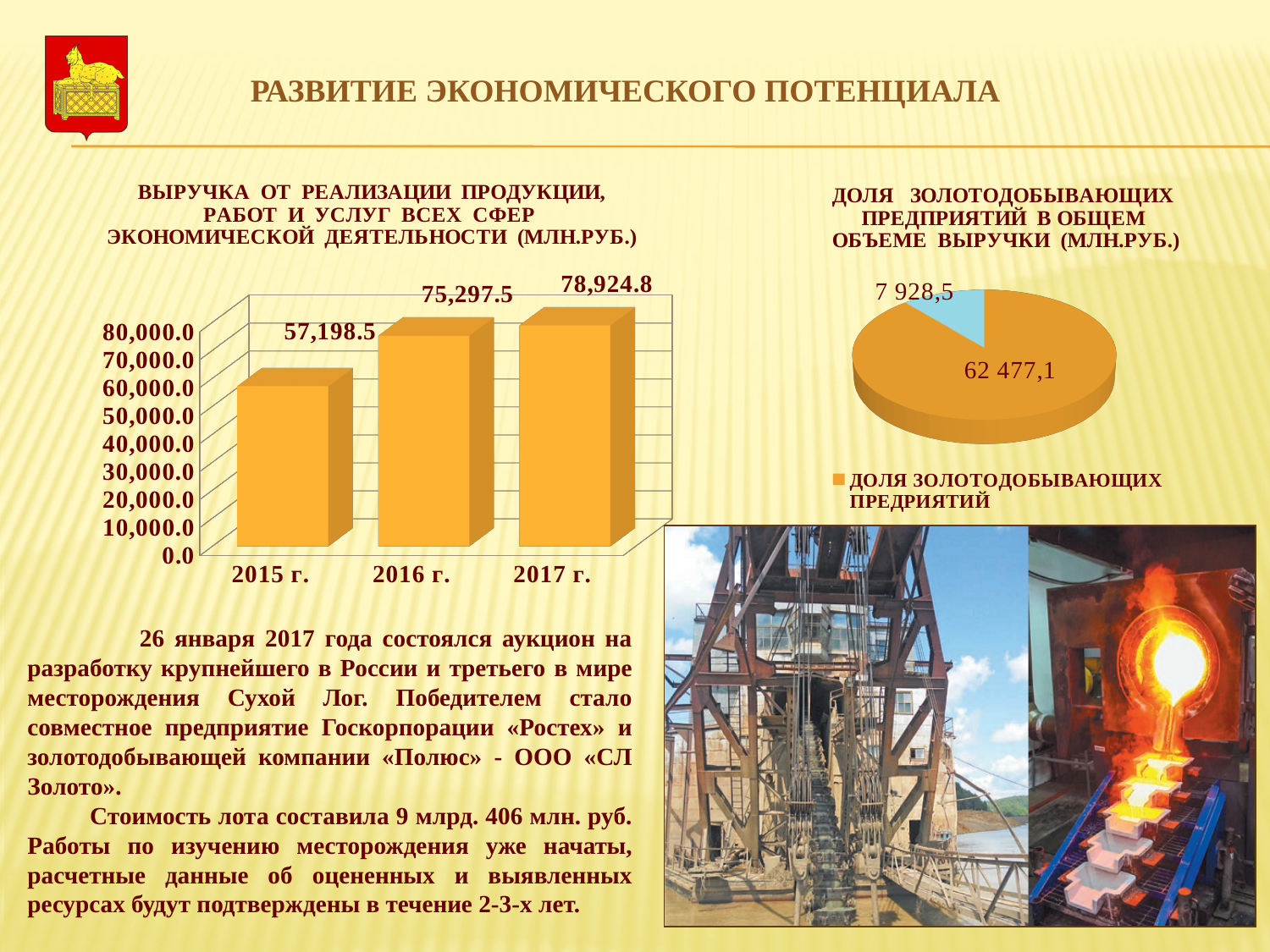
In the bar chart on the left, what is the value for 2015 г.? 57,198.5 In the bar chart on the left, what is the difference between the values for 2017 г. and 2016 г.? 3,627.3 In the bar chart on the left, which year has the lowest value? 2015 г. In the bar chart on the left, what is the value for 2017 г.? 78,924.8 What kind of chart is the chart on the right (share of gold-mining enterprises in total revenue)? pie chart In the bar chart on the left (revenue from sales of products, works and services), what is the value for 2016 г.? 75,297.5 In the bar chart on the left, which year has the highest value? 2017 г. In the pie chart on the right, what is the value of the smaller (blue) slice? 7 928,5 In the pie chart on the right, what is the value of the larger (orange) slice? 62 477,1 In the bar chart on the left, what is the difference between the values for 2016 г. and 2015 г.? 18,099.0 In the bar chart on the left, do the values rise or fall from 2015 г. to 2017 г.? rise How many years (categories) are shown in the bar chart on the left? 3